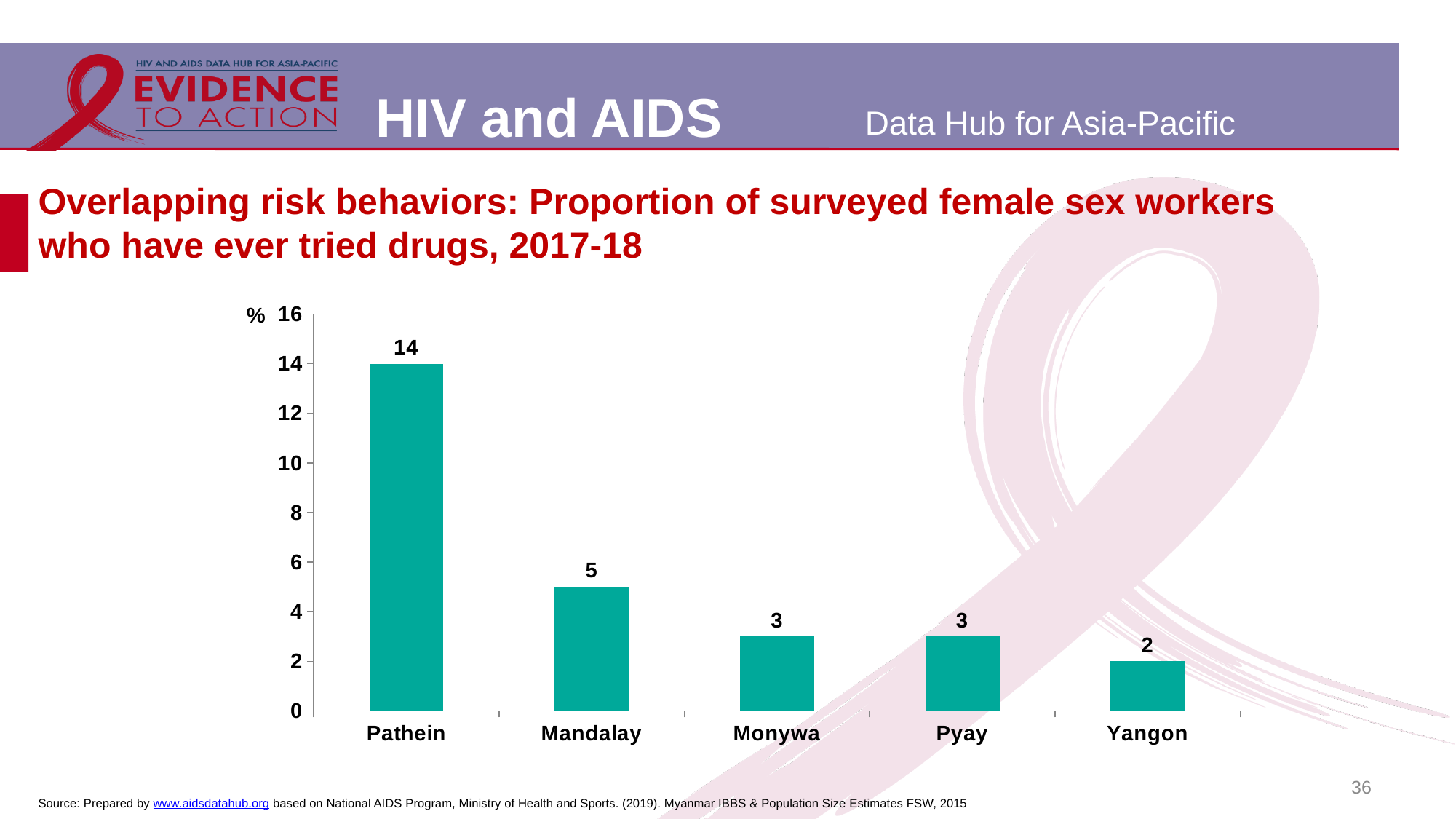
What is the value for Pathein? 14 What is the difference between the values for Pathein and Mandalay? 9 Is the value for Pathein greater or less than 10? greater What is the value for Mandalay? 5 What is the difference between the values for Monywa and Yangon? 1 What is the value for Yangon? 2 Which is larger, the value for Mandalay or the value for Pyay? Mandalay What unit is shown on the y axis of the chart? % Which city has the lowest proportion of surveyed female sex workers who have ever tried drugs? Yangon Which city has the highest proportion of surveyed female sex workers who have ever tried drugs? Pathein What type of chart is shown on the slide? bar chart How many cities are shown on the chart? 5